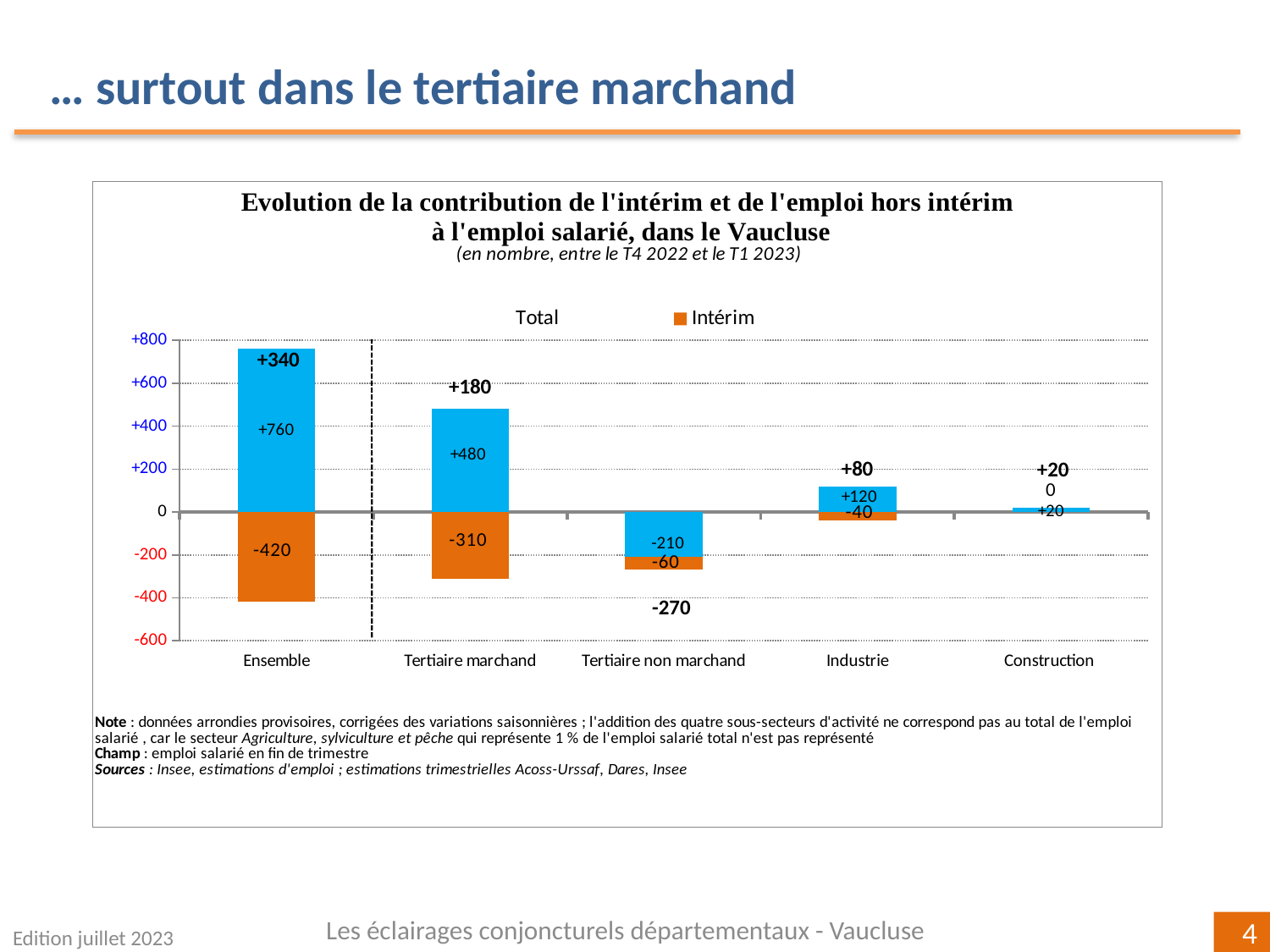
How many series does the legend list? 2 What is the Intérim value for Construction? 0 What is the total value shown for Ensemble? +340 What is the Intérim value for Tertiaire marchand? -310 What is the difference between the blue bar values for Ensemble (+760) and Tertiaire marchand (+480)? 280 Between which two quarters does the chart measure the change, according to the subtitle? Entre le T4 2022 et le T1 2023 Which has the larger Intérim decline, Ensemble or Tertiaire marchand? Ensemble How many categories are shown on the x axis? 5 What value is printed on the blue bar for Industrie? +120 Which category has the highest total value? Ensemble Which category has the lowest total value? Tertiaire non marchand What kind of chart is this? Bar chart